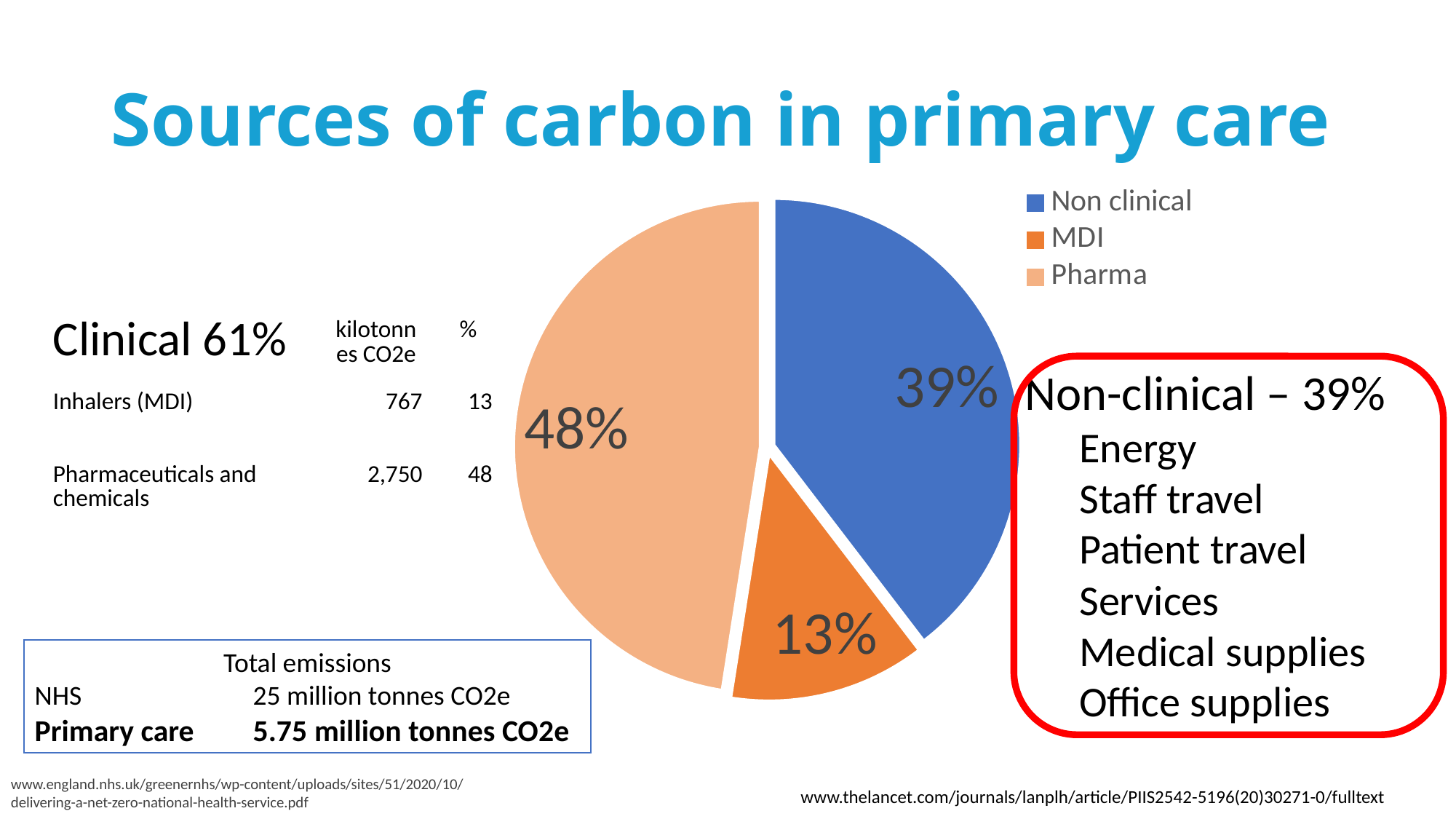
What is the combined share of the MDI and Pharma slices? 61% What share of the pie does MDI account for? 13% Which slice is larger, Non clinical or MDI? Non clinical How many entries does the legend list? 3 Which category has the smallest slice of the pie? MDI How many slices does the pie chart have? 3 What is the difference in percentage points between the Pharma slice and the Non clinical slice? 9 What colour is the MDI slice in the pie chart? orange What kind of chart is shown on the slide? pie chart What share of the pie does Non clinical account for? 39% What share of the pie does Pharma account for? 48% Which category has the largest slice of the pie? Pharma